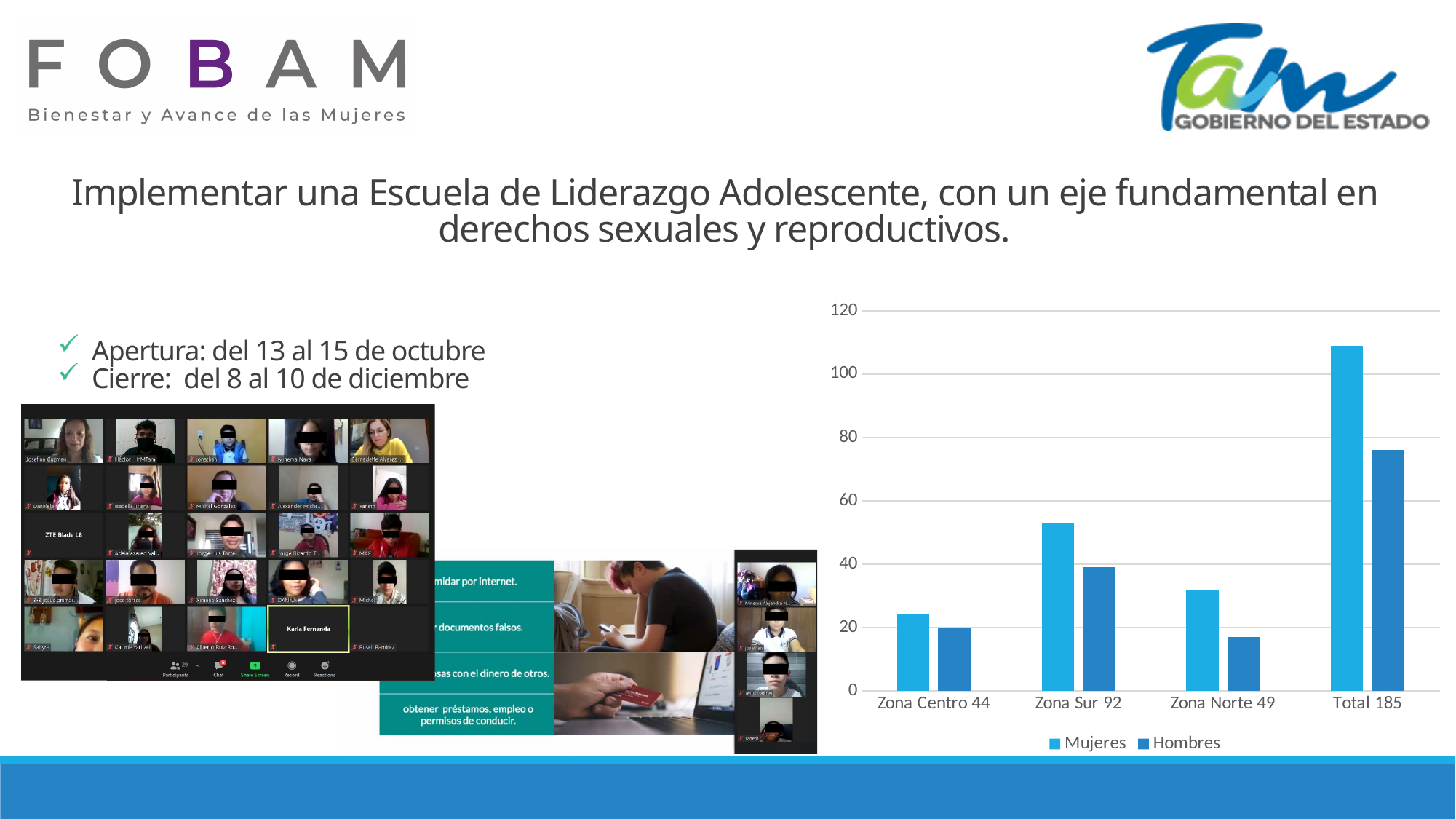
In Zona Sur 92, which is larger, Mujeres or Hombres? Mujeres Is the Hombres value for Total 185 greater or less than 60? greater Is the Hombres value for Zona Norte 49 greater or less than 20? less Is the Mujeres value for Total 185 greater or less than 100? greater Which series are listed in the chart legend? Mujeres, Hombres Which category has the lowest Hombres value? Zona Norte 49 How many categories are shown on the x axis of the chart? 4 What kind of chart is shown on the slide? bar chart Which category has the highest Mujeres value? Total 185 Which is larger, the Mujeres value for Zona Centro 44 or the Mujeres value for Zona Norte 49? Zona Norte 49 How many series does the chart legend list? 2